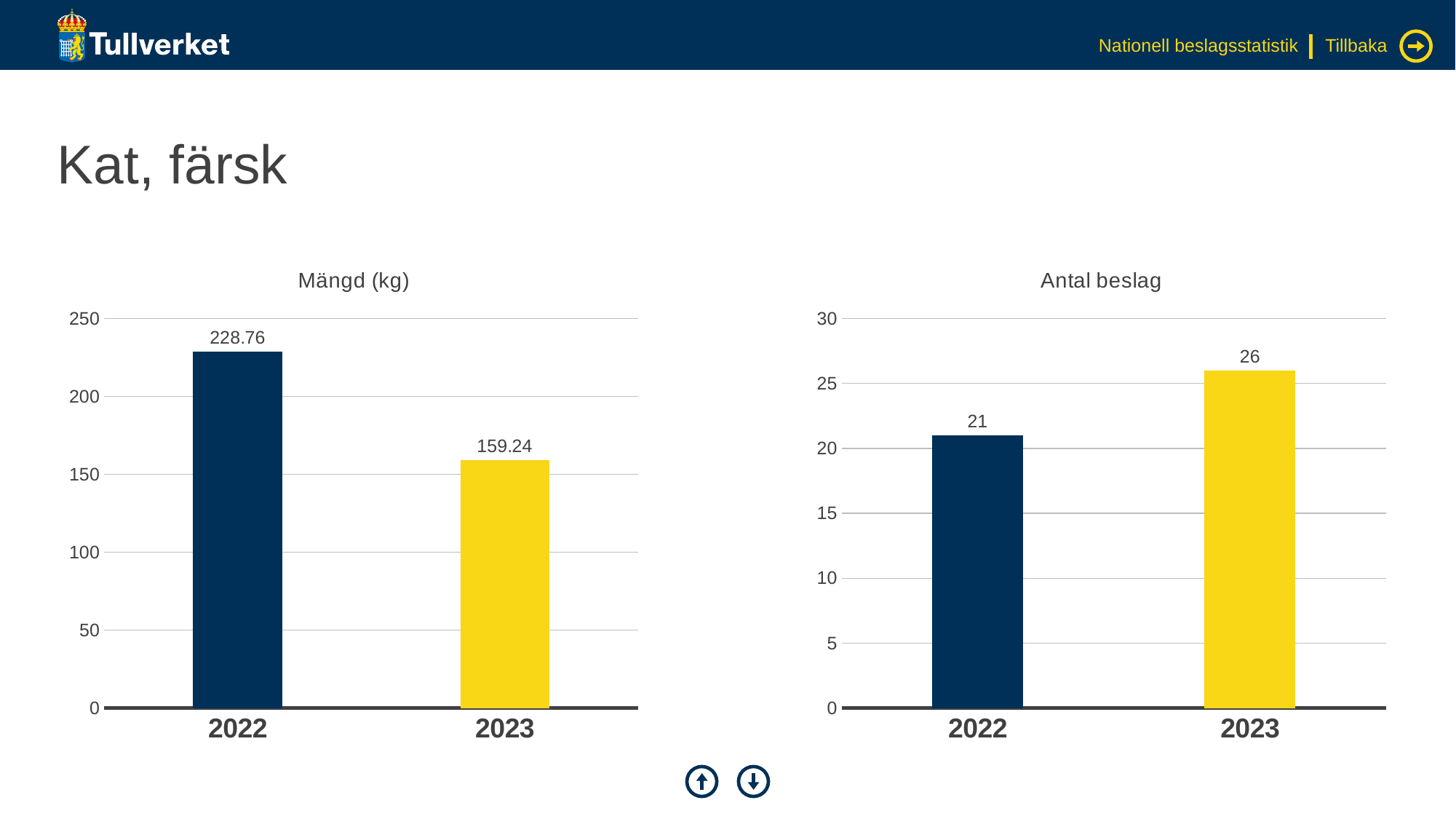
In the 'Mängd (kg)' chart, what is the value for 2022? 228.76 In the 'Antal beslag' chart, what is the difference between the 2023 and 2022 values? 5 In the 'Antal beslag' chart, which year has the lowest value? 2022 In the 'Antal beslag' chart, what is the value for 2023? 26 In the 'Mängd (kg)' chart, what is the value for 2023? 159.24 What kind of chart is the 'Mängd (kg)' chart? bar chart In the 'Antal beslag' chart, what is the value for 2022? 21 How many categories are shown in the 'Antal beslag' chart? 2 In the 'Antal beslag' chart, which is larger, the value for 2022 or 2023? 2023 In the 'Mängd (kg)' chart, do the values rise or fall from 2022 to 2023? fall In the 'Mängd (kg)' chart, which year has the highest value? 2022 In the 'Mängd (kg)' chart, what is the difference between the 2022 and 2023 values? 69.52